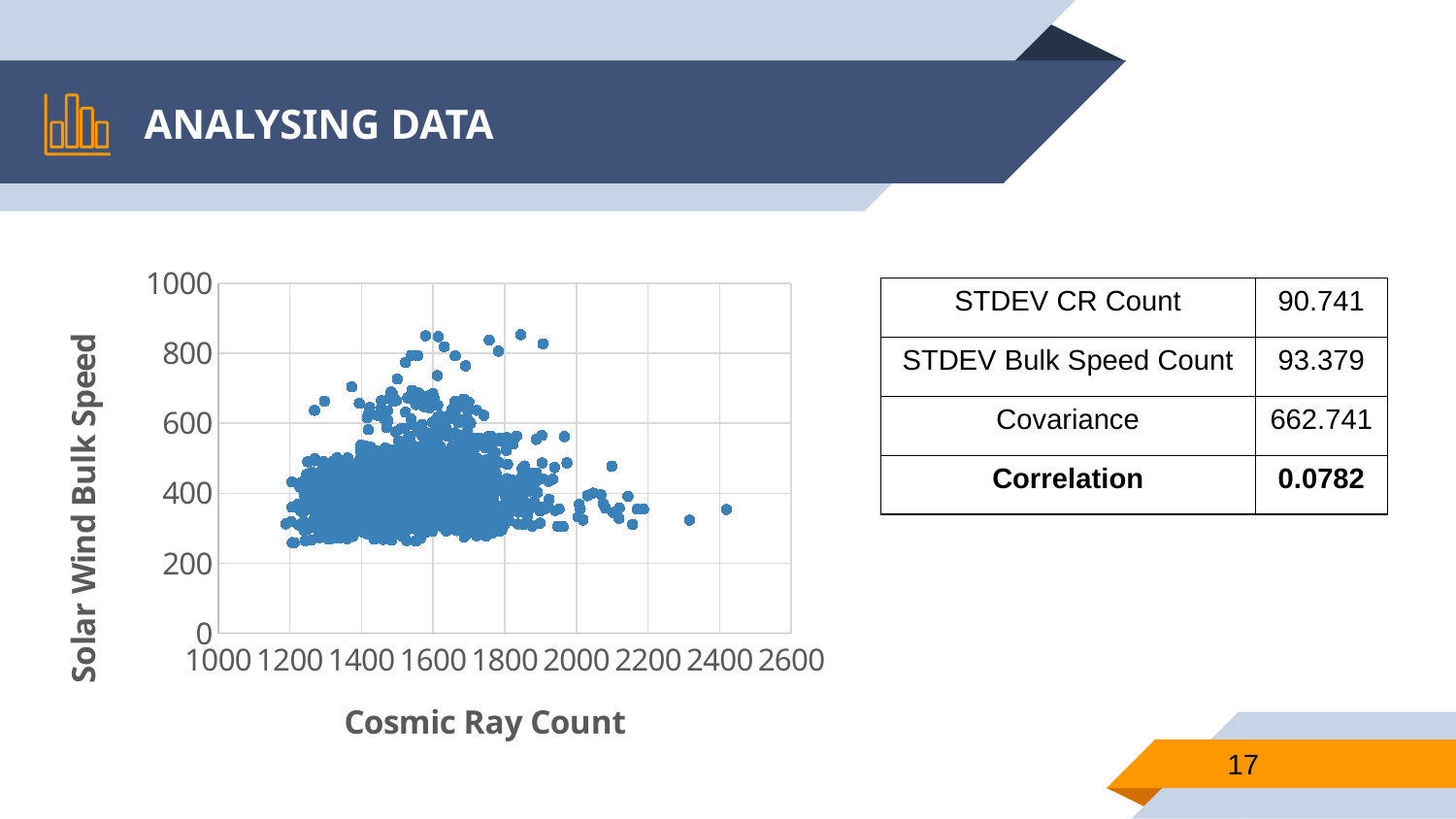
Is the lowest Solar Wind Bulk Speed value plotted in the scatter chart greater or less than 200? greater What is the title of the y axis of the scatter chart? Solar Wind Bulk Speed What kind of chart is shown on the slide? scatter chart Are any points in the scatter chart plotted above a Solar Wind Bulk Speed of 1000? no Is the smallest Cosmic Ray Count value plotted in the scatter chart greater or less than 1000? greater Do the points in the scatter chart show a clear rising or falling trend as Cosmic Ray Count increases? no clear trend What is the title of the x axis of the scatter chart? Cosmic Ray Count